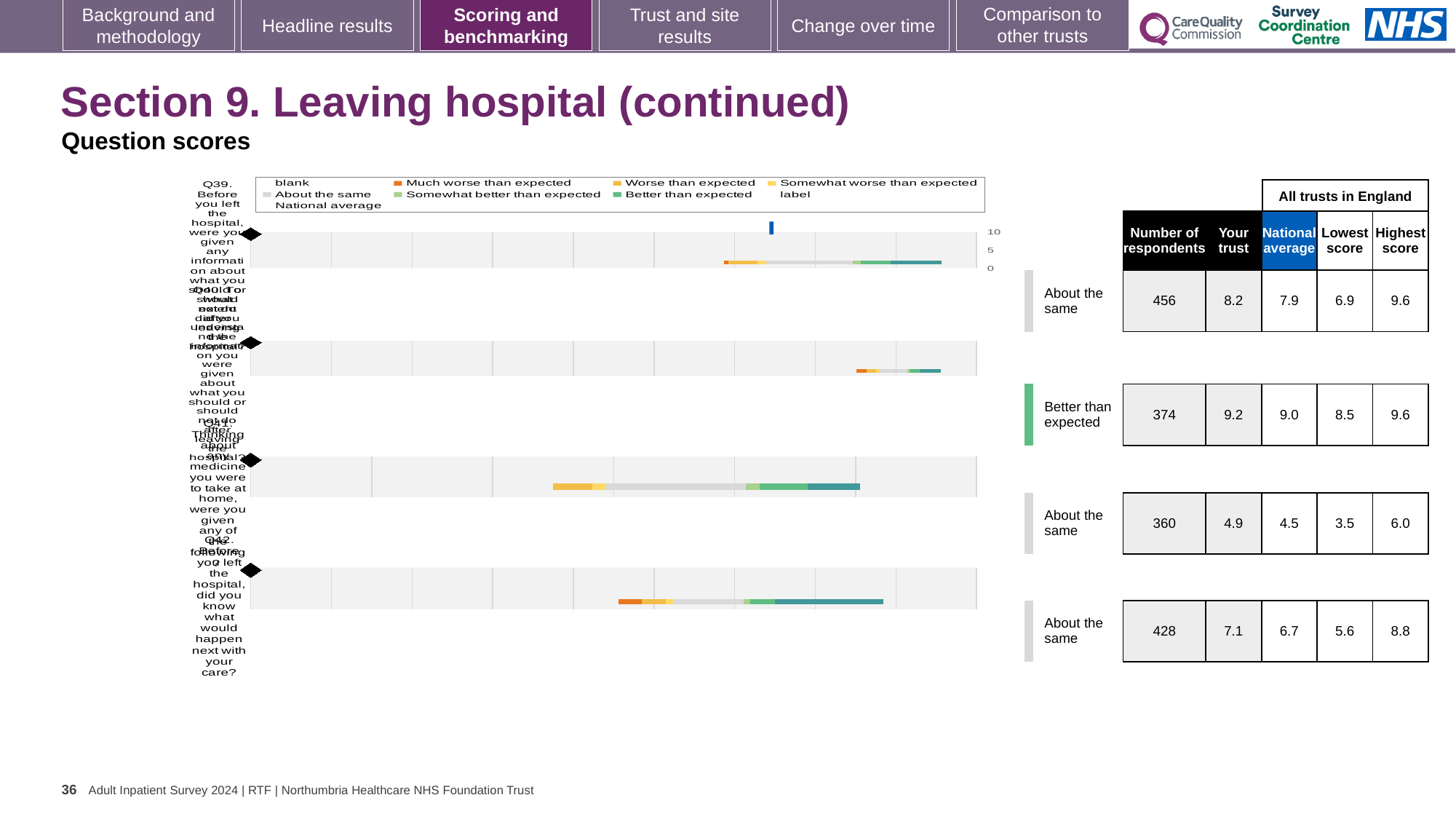
In the table beside the chart, what is the Highest score in the fourth row (Q42)? 8.8 Which row of the table has the lowest 'Your trust' score? the third row (4.9) In the table beside the chart, what is the National average in the second row (Q40)? 9.0 How many question bars are plotted in the chart? 4 In the table beside the chart, how many respondents are listed in the third row (Q41)? 360 What kind of chart is shown on the slide? bar chart In the second row of the table, which is larger: the 'Your trust' score or the National average? Your trust In the first row of the table, what is the difference between the 'Your trust' score and the National average? 0.3 In the table beside the chart, what is the 'Your trust' score in the first row (Q39)? 8.2 Which legend entry is shown in orange in the chart's legend? Much worse than expected Which legend entry is shown in dark green in the chart's legend? Better than expected Which row of the table has the highest 'Your trust' score? Better than expected (9.2)